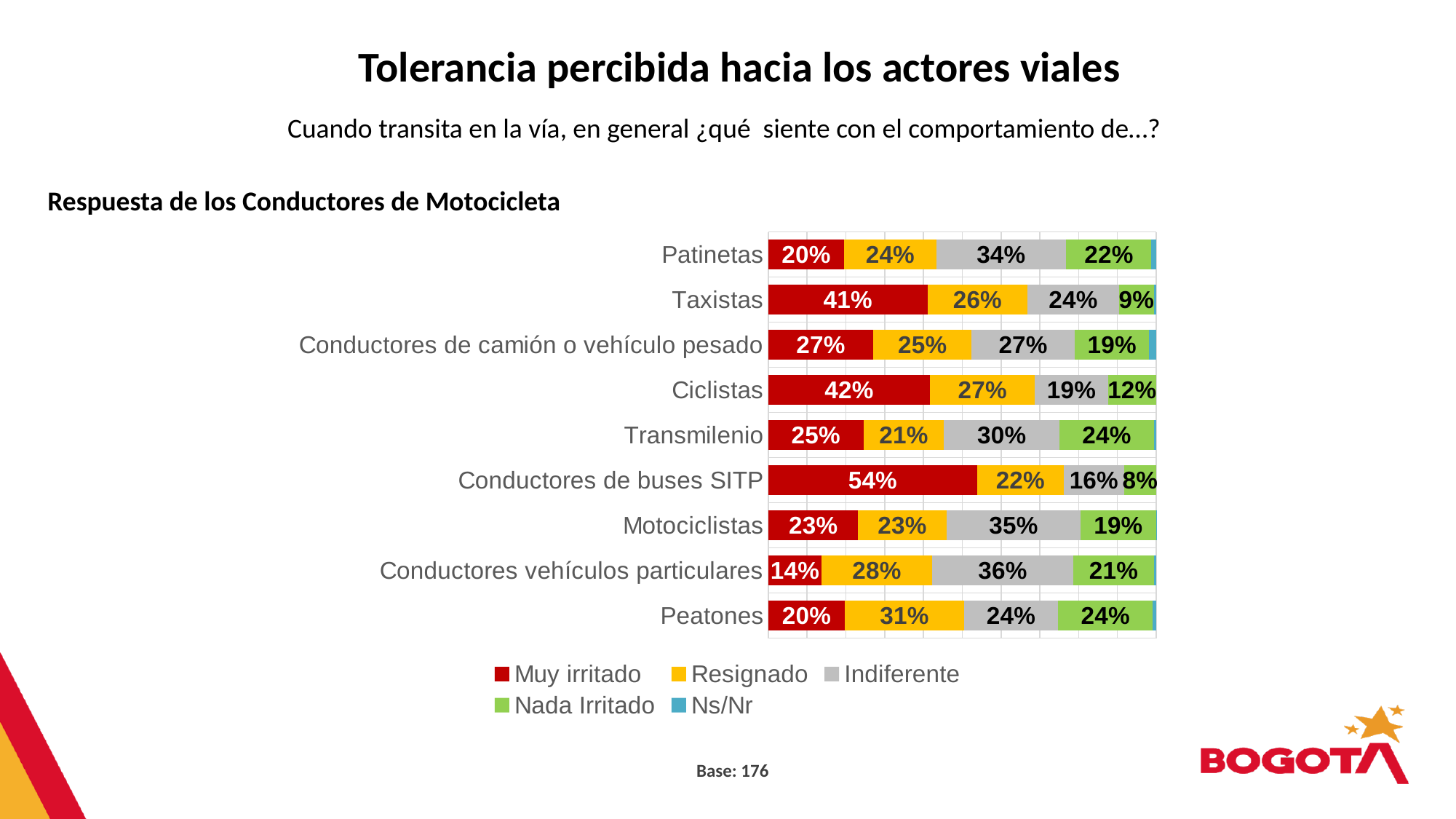
What percentage of motorcycle drivers answered "Muy irritado" about Conductores de buses SITP? 54% How many road actor categories are shown in the chart? 9 What is the "Nada Irritado" value for Taxistas? 9% What is the "Resignado" value for Peatones? 31% What is the "Indiferente" value for Conductores vehículos particulares? 36% Which category has the highest "Muy irritado" value? Conductores de buses SITP What type of chart is shown on the slide? Stacked bar chart Which colour represents "Muy irritado" in the chart? Red What is the difference in percentage points between the "Muy irritado" values for Conductores de buses SITP and Conductores vehículos particulares? 40 percentage points Which category has the lowest "Muy irritado" value? Conductores vehículos particulares Which is larger: the "Indiferente" value for Motociclistas or for Ciclistas? Motociclistas How many series does the legend list? 5